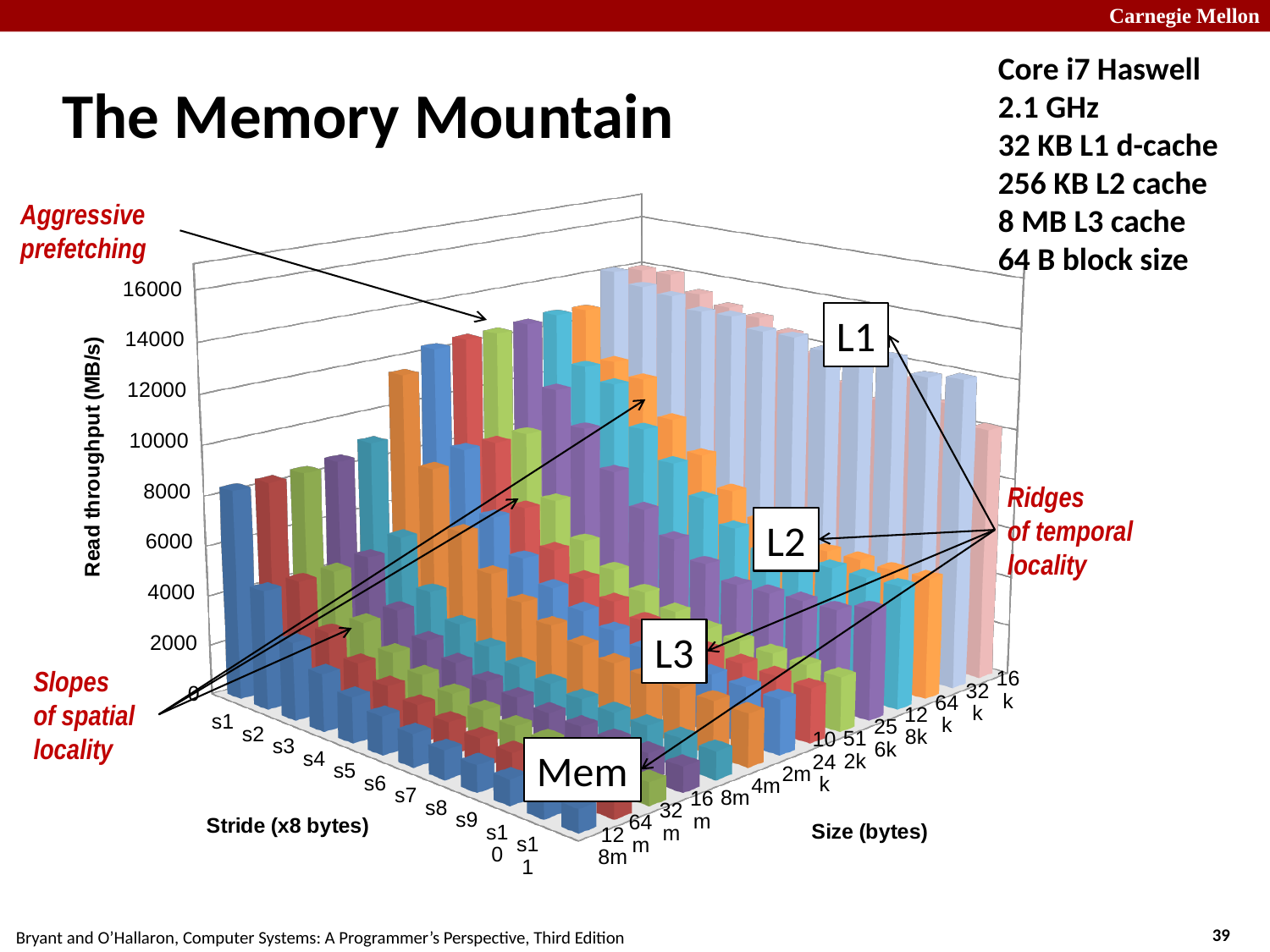
Which stride value gives the highest read throughput across the chart? s1 Which labelled region of the chart has the lowest read throughput? Mem Which cache region labelled on the chart has the highest read throughput? L1 Which has higher read throughput: the L2 region or the L3 region? L2 What kind of chart is shown on the slide? bar chart What is the highest value marked on the vertical axis of the chart? 16000 Which has higher read throughput: the L1 region or the Mem region? L1 Is the tallest bar in the chart (L1 region, stride s1) greater or less than 12000 MB/s? greater What quantity is plotted on the vertical axis of the chart? Read throughput (MB/s) How many stride categories (s1 through s11) are shown along the stride axis? 11 For the largest working-set sizes, does read throughput rise or fall as the stride increases from s1 to s11? fall What is the title of the chart on the slide? The Memory Mountain